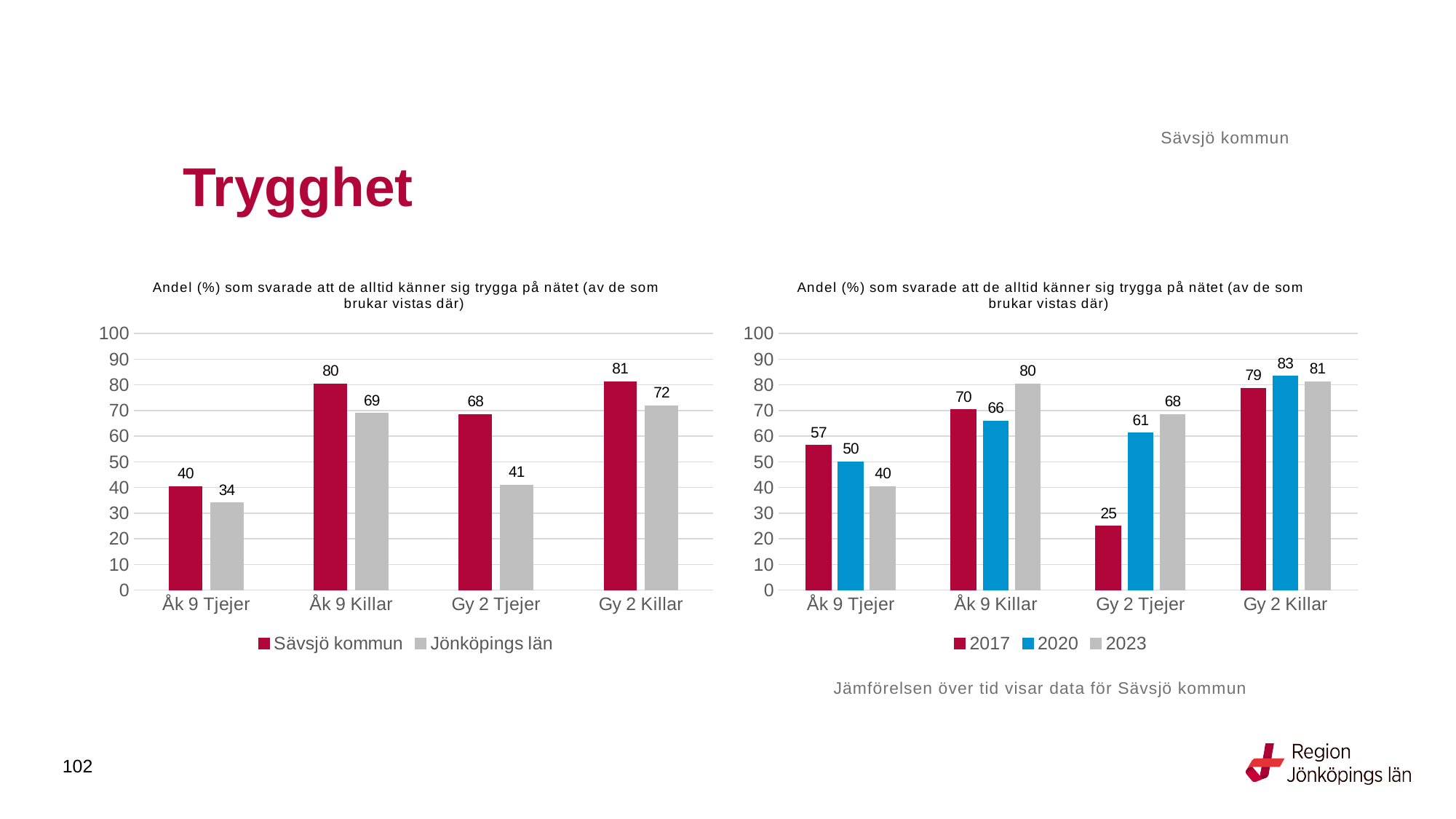
In the left chart, what is the value for Jönköpings län for Gy 2 Killar? 72 In the left chart, which category has the lowest value for Jönköpings län? Åk 9 Tjejer In the right chart, what is the value for 2020 for Gy 2 Tjejer? 61 In the left chart, what is the value for Sävsjö kommun for Åk 9 Tjejer? 40 In the right chart, which category has the lowest value for 2017? Gy 2 Tjejer In the right chart, how many categories are shown on the x axis? 4 In the right chart, what is the value for 2017 for Åk 9 Killar? 70 What kind of chart is the right chart? bar chart In the left chart, which category has the highest value for Sävsjö kommun? Gy 2 Killar In the left chart, how many series does the legend list? 2 In the left chart, what is the difference between Sävsjö kommun and Jönköpings län for Gy 2 Tjejer? 27 In the right chart, is the value for 2023 for Åk 9 Tjejer larger or smaller than the value for 2020 for Åk 9 Tjejer? smaller